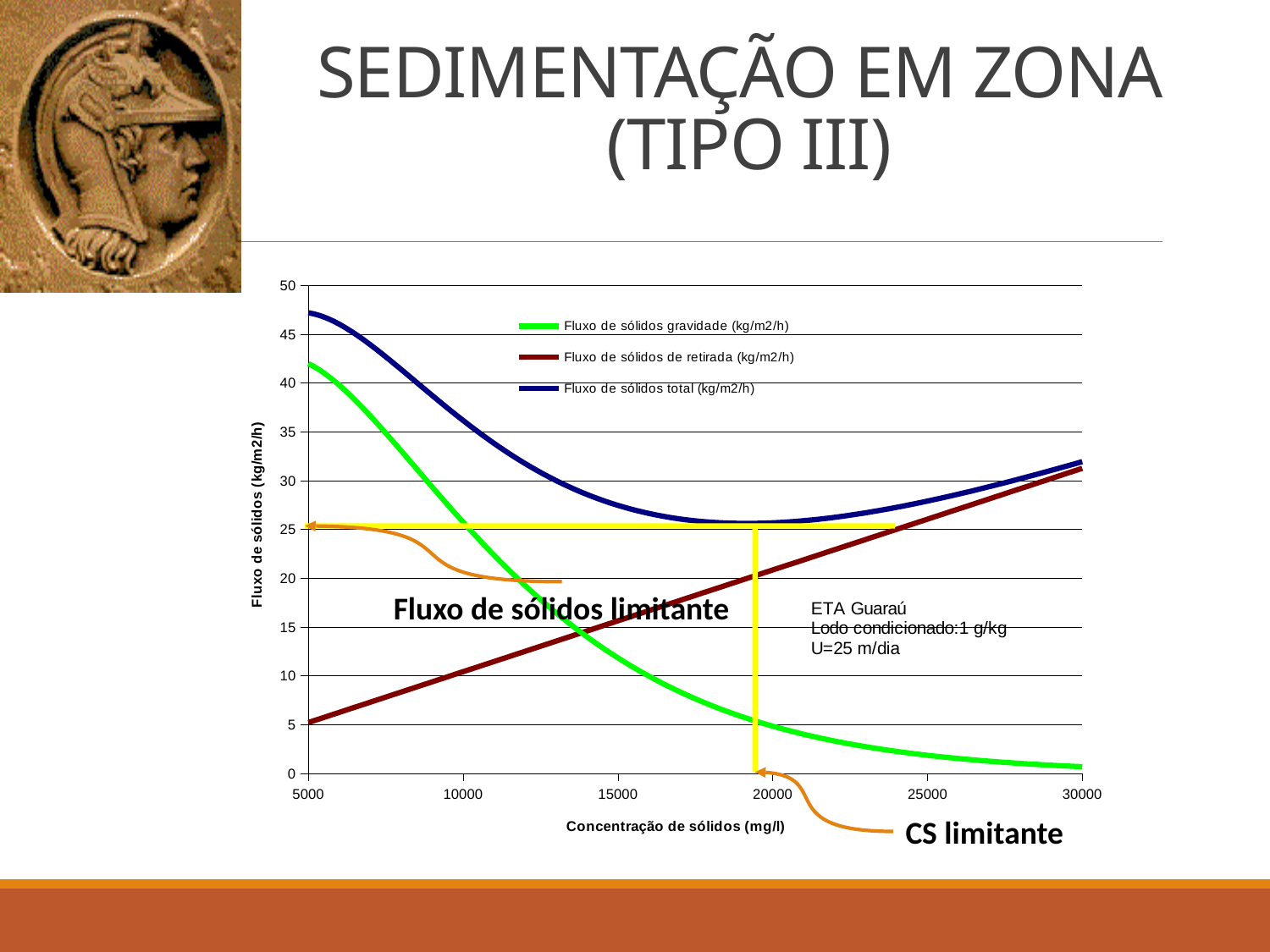
Is the value of 'Fluxo de sólidos total (kg/m2/h)' at a concentration of 5000 greater or less than 45? greater Is the value of 'Fluxo de sólidos gravidade (kg/m2/h)' at a concentration of 5000 greater or less than 40? greater How many series does the chart legend list? 3 What kind of chart is shown on the slide? line chart What is the title of the x axis of the chart? Concentração de sólidos (mg/l) Does the 'Fluxo de sólidos de retirada (kg/m2/h)' series rise or fall as the concentration increases along the x axis? rise Is the value of 'Fluxo de sólidos de retirada (kg/m2/h)' at a concentration of 30000 greater or less than 25? greater Does the 'Fluxo de sólidos gravidade (kg/m2/h)' series rise or fall as the concentration increases along the x axis? fall What is the title of the y axis of the chart? Fluxo de sólidos (kg/m2/h) At a concentration of 10000, which series has the larger value: 'Fluxo de sólidos gravidade (kg/m2/h)' or 'Fluxo de sólidos de retirada (kg/m2/h)'? Fluxo de sólidos gravidade (kg/m2/h) At a concentration of 30000, which series has the larger value: 'Fluxo de sólidos de retirada (kg/m2/h)' or 'Fluxo de sólidos gravidade (kg/m2/h)'? Fluxo de sólidos de retirada (kg/m2/h)